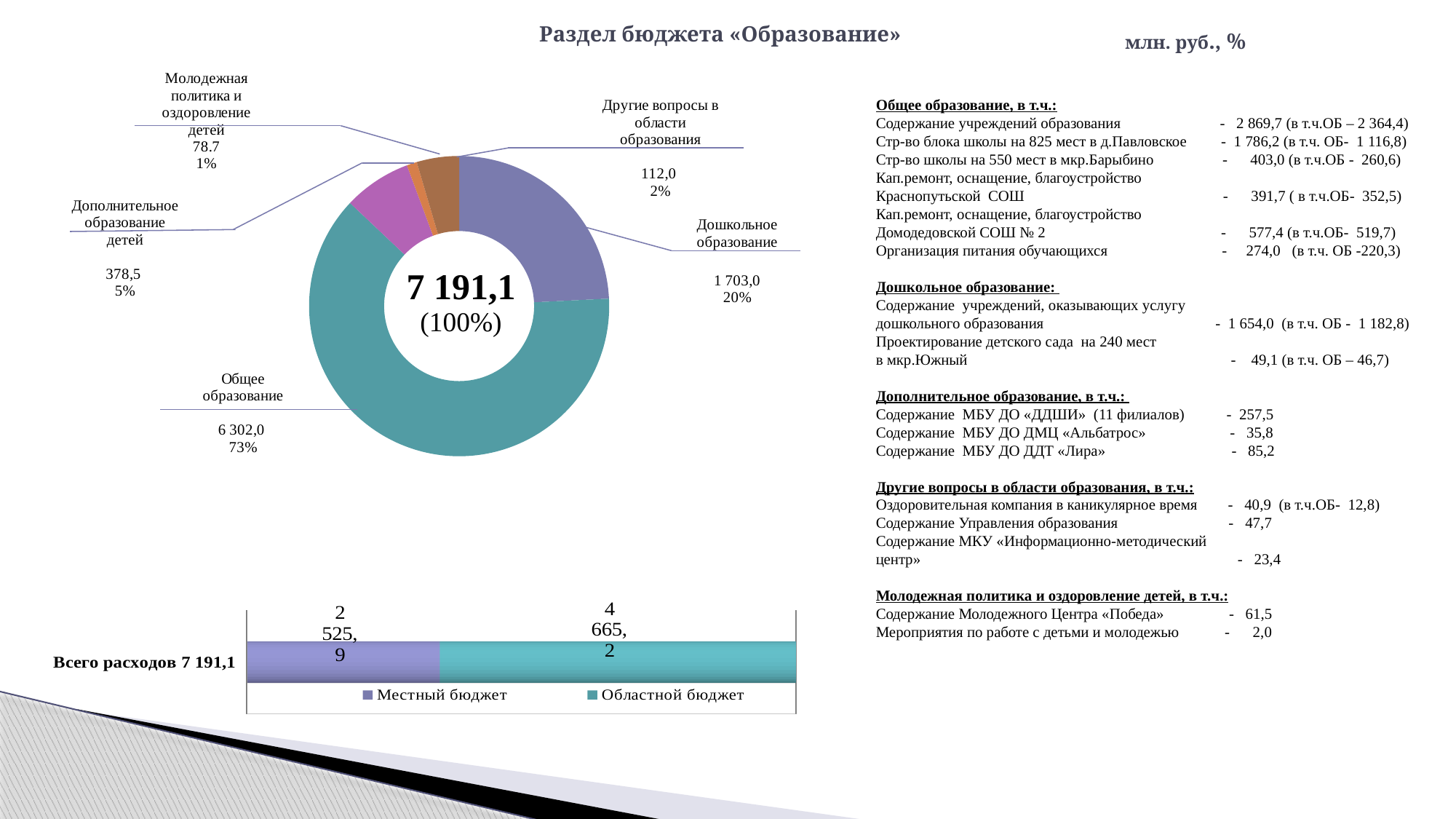
On the doughnut chart, what total value is printed in the centre? 7 191,1 On the bottom bar chart, how many series does the legend list? 2 On the bottom bar chart, which is larger, Местный бюджет or Областной бюджет? Областной бюджет On the bottom bar chart, what is the value for Областной бюджет? 4 665,2 On the doughnut chart, what share does Дополнительное образование детей have? 5% On the doughnut chart, what is the value for Дошкольное образование? 1 703,0 On the doughnut chart, which category has the smallest share? Молодежная политика и оздоровление детей On the doughnut chart, how many categories are shown? 5 What kind of chart is the chart at the bottom of the slide? Bar chart On the doughnut chart, which category has the largest share? Общее образование On the doughnut chart, what is the difference between Общее образование and Дошкольное образование? 4 599,0 On the doughnut chart, what is the value for Общее образование? 6 302,0